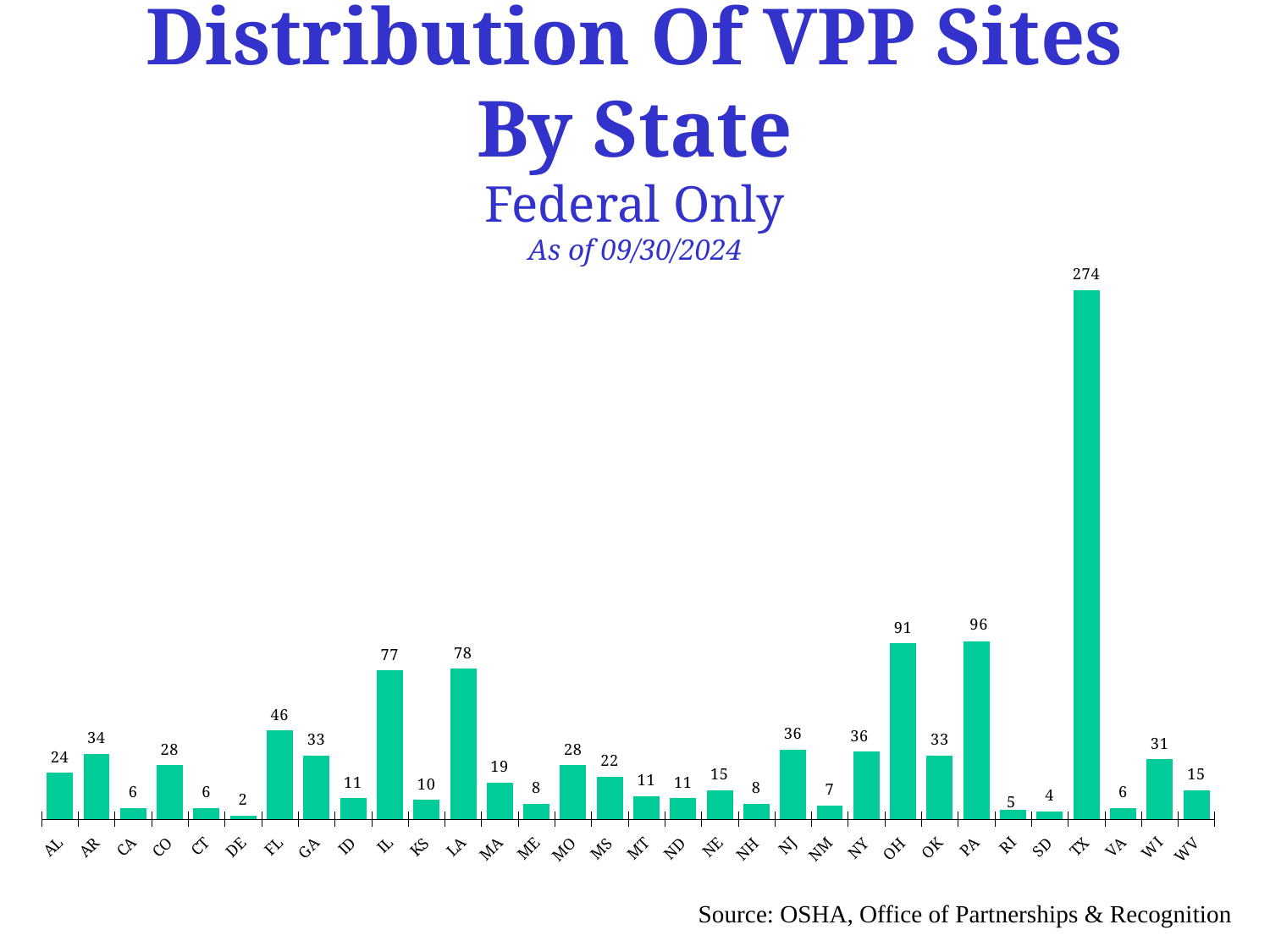
Which has a larger value, AR or WI? AR Which state has the highest number of VPP sites? TX How many VPP sites does Texas (TX) have? 274 What kind of chart is shown on the slide? Bar chart How many states are shown on the x axis? 32 What is the difference between the values for OH and NJ? 55 Which state has the lowest number of VPP sites? DE Which has a larger value, PA or OH? PA What is the value shown for MA? 19 What is the value shown for OH? 91 What is the difference between the values for TX and PA? 178 What is the value shown for FL? 46